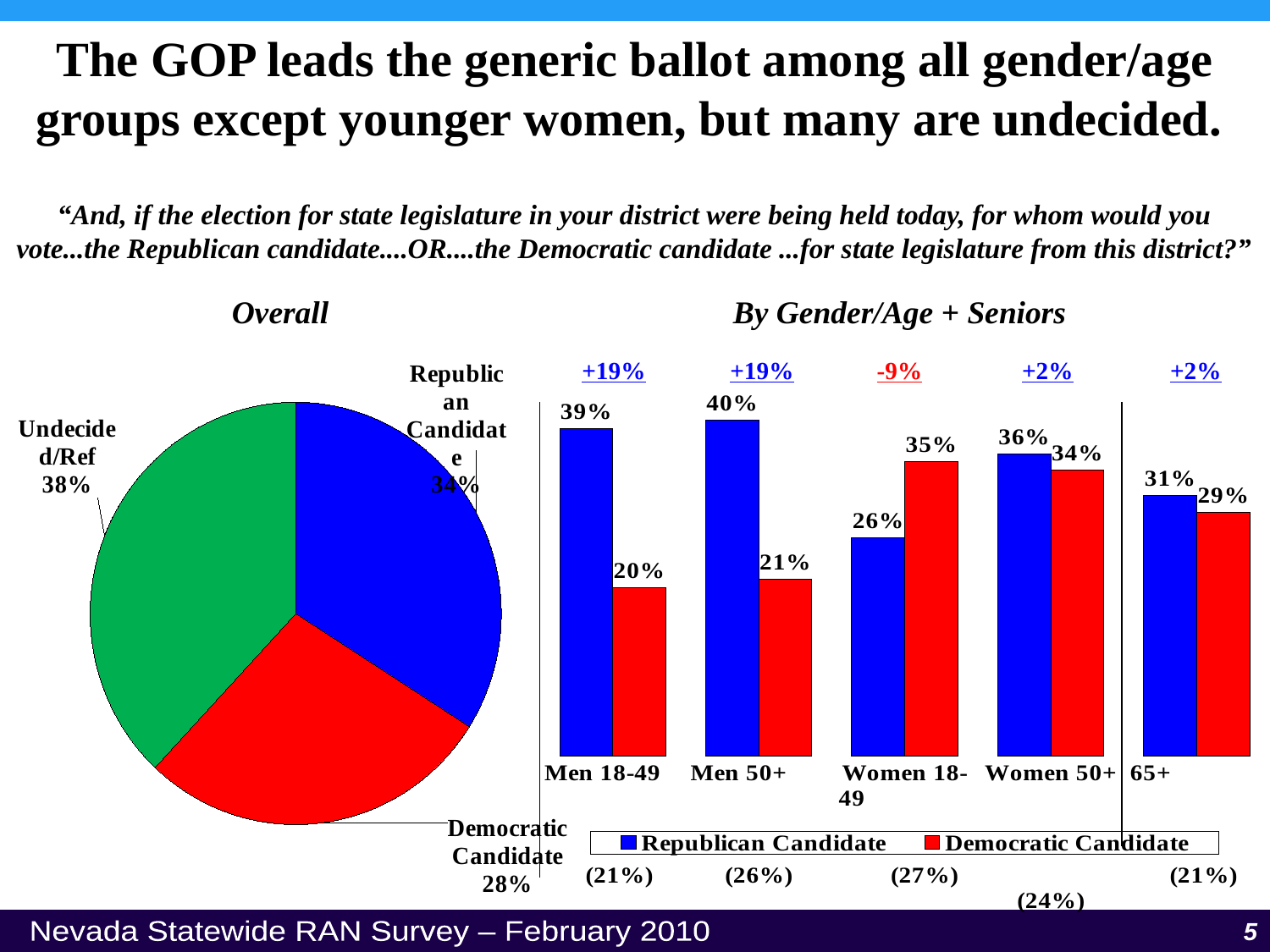
In the By Gender/Age + Seniors chart, which is larger for Women 18-49: the Republican Candidate or the Democratic Candidate value? Democratic Candidate In the By Gender/Age + Seniors chart, which group has the lowest Democratic Candidate value? Men 18-49 In the By Gender/Age + Seniors chart, which group has the highest Republican Candidate value? Men 50+ What kind of chart is the Overall chart? Pie chart In the By Gender/Age + Seniors chart, what is the value for the Democratic Candidate among Women 18-49? 35% In the By Gender/Age + Seniors chart, what is the value for the Republican Candidate among Men 50+? 40% How many groups are shown on the x axis of the By Gender/Age + Seniors chart? 5 In the By Gender/Age + Seniors chart, what is the difference between the Republican and Democratic Candidate values for Men 18-49? 19% In the Overall pie chart, what is the difference between the Republican Candidate and Democratic Candidate shares? 6% In the Overall pie chart, what share of respondents are Undecided/Ref? 38% In the Overall pie chart, which slice is the largest? Undecided/Ref How many series does the legend of the By Gender/Age + Seniors chart list? 2